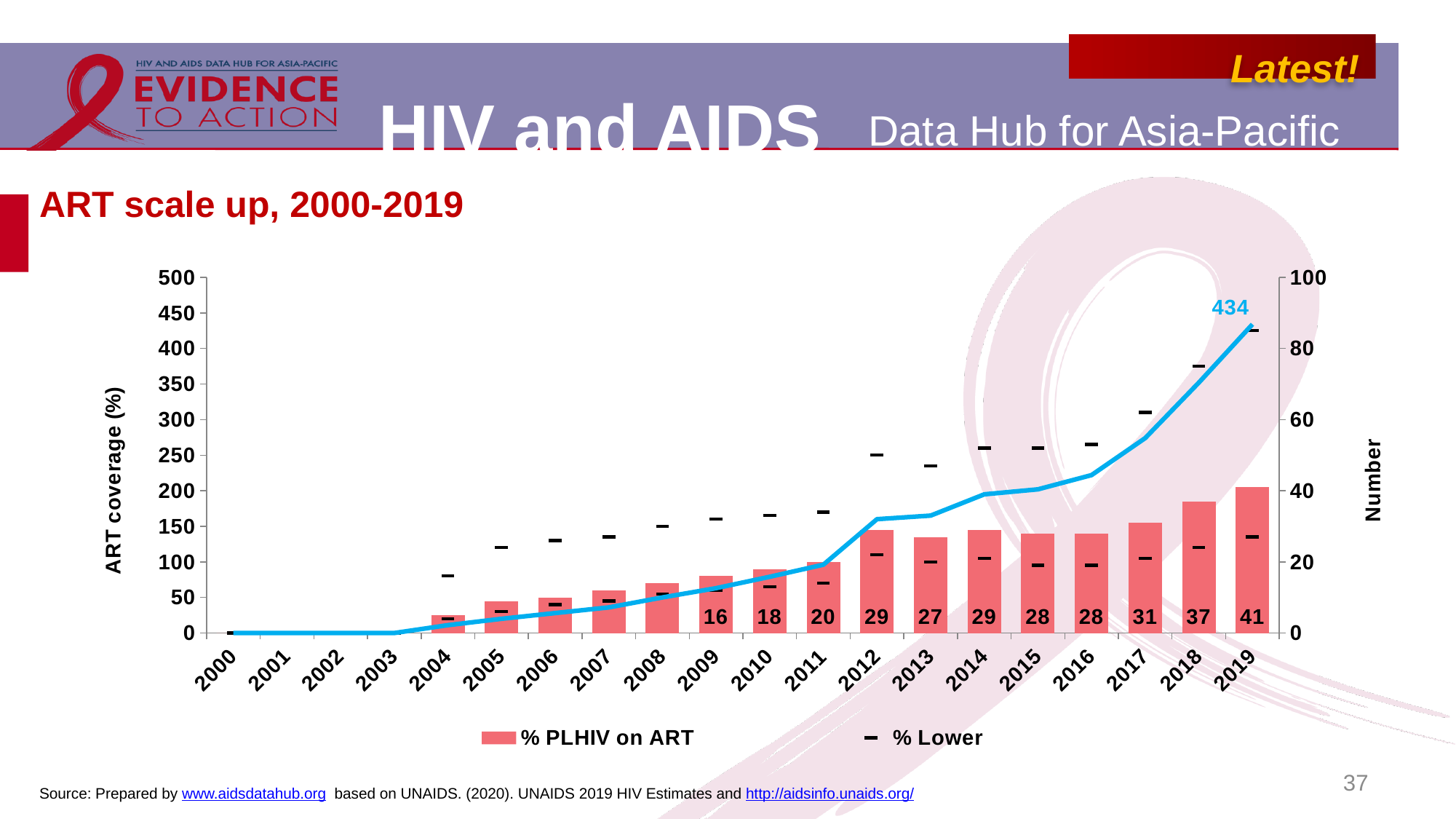
How many series does the legend list? 2 What is the difference between the % PLHIV on ART values for 2019 and 2018? 4 Which year has a larger % PLHIV on ART, 2013 or 2014? 2014 Is the % PLHIV on ART bar for 2008 greater or less than 20 on the right-hand axis? less What is the difference between the % PLHIV on ART values for 2012 and 2011? 9 Which year has the highest % PLHIV on ART? 2019 What is the % PLHIV on ART value for 2018? 37 Does the line for Number rise or fall from 2003 to 2019? rise How many years are shown on the x axis? 20 What value is labelled on the line at 2019? 434 What is the % PLHIV on ART value for 2019? 41 What is the % PLHIV on ART value for 2012? 29